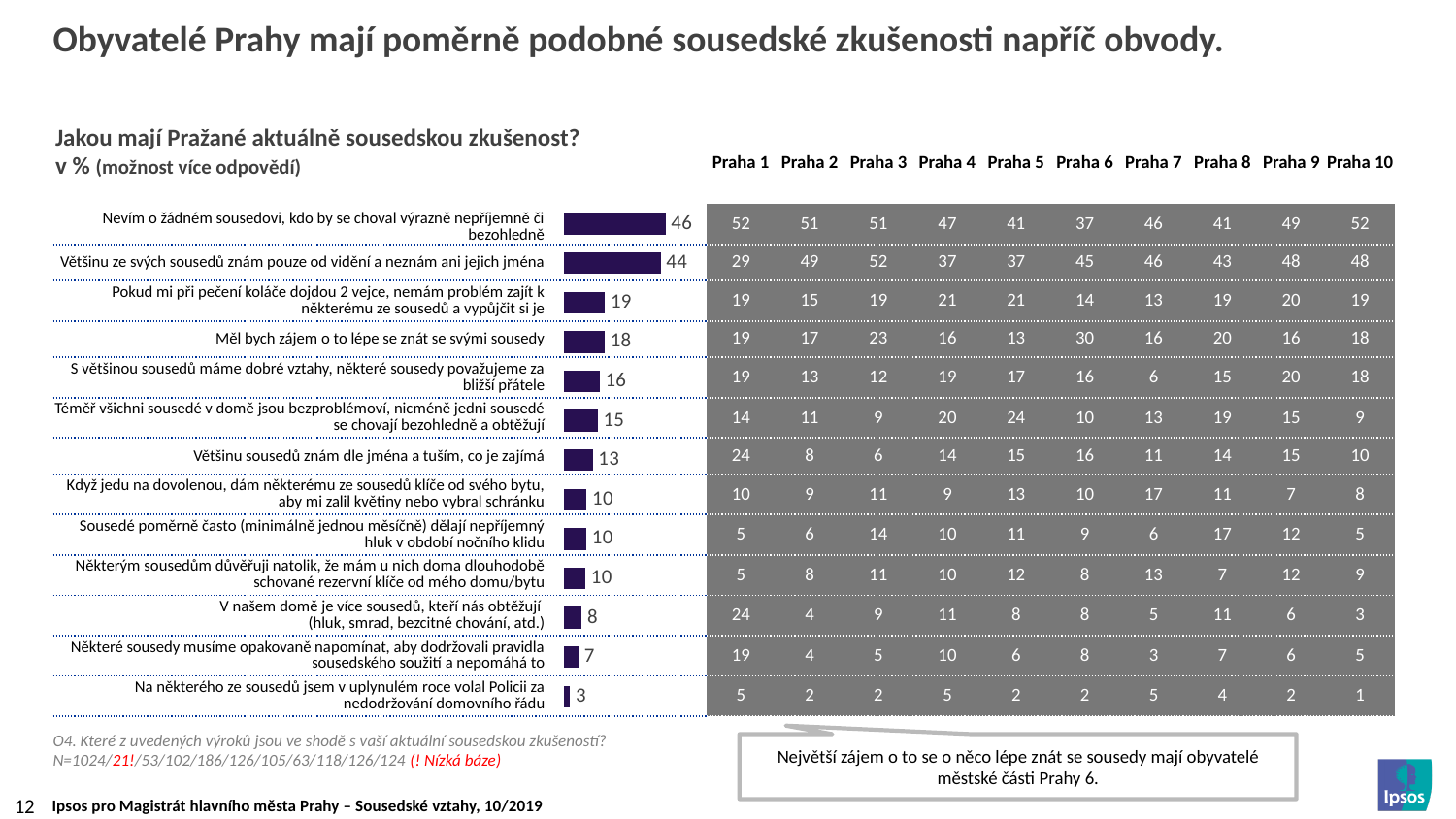
What is the value for "Většinu ze svých sousedů znám pouze od vidění a neznám ani jejich jména" in the bar chart? 44 Which statement has the highest value in the bar chart? Nevím o žádném sousedovi, kdo by se choval výrazně nepříjemně či bezohledně Which is larger in the bar chart: the value for "Většinu sousedů znám dle jména a tuším, co je zajímá" or for "V našem domě je více sousedů, kteří nás obtěžují"? Většinu sousedů znám dle jména a tuším, co je zajímá In the table, what is the value for "Měl bych zájem o to lépe se znát se svými sousedy" in Praha 6? 30 What is the value for "Měl bych zájem o to lépe se znát se svými sousedy" in the bar chart? 18 How many categories (statements) does the bar chart show? 13 How many Prague districts (Praha 1 to Praha 10) are listed as columns in the table? 10 What is the value for "Nevím o žádném sousedovi, kdo by se choval výrazně nepříjemně či bezohledně" in the bar chart? 46 What is the difference between the values for "Nevím o žádném sousedovi..." (46) and "Většinu ze svých sousedů znám pouze od vidění..." (44)? 2 Which statement has the lowest value in the bar chart? Na některého ze sousedů jsem v uplynulém roce volal Policii za nedodržování domovního řádu In the table, what is the value for "Nevím o žádném sousedovi, kdo by se choval výrazně nepříjemně či bezohledně" in Praha 1? 52 What kind of chart is shown on the slide? bar chart